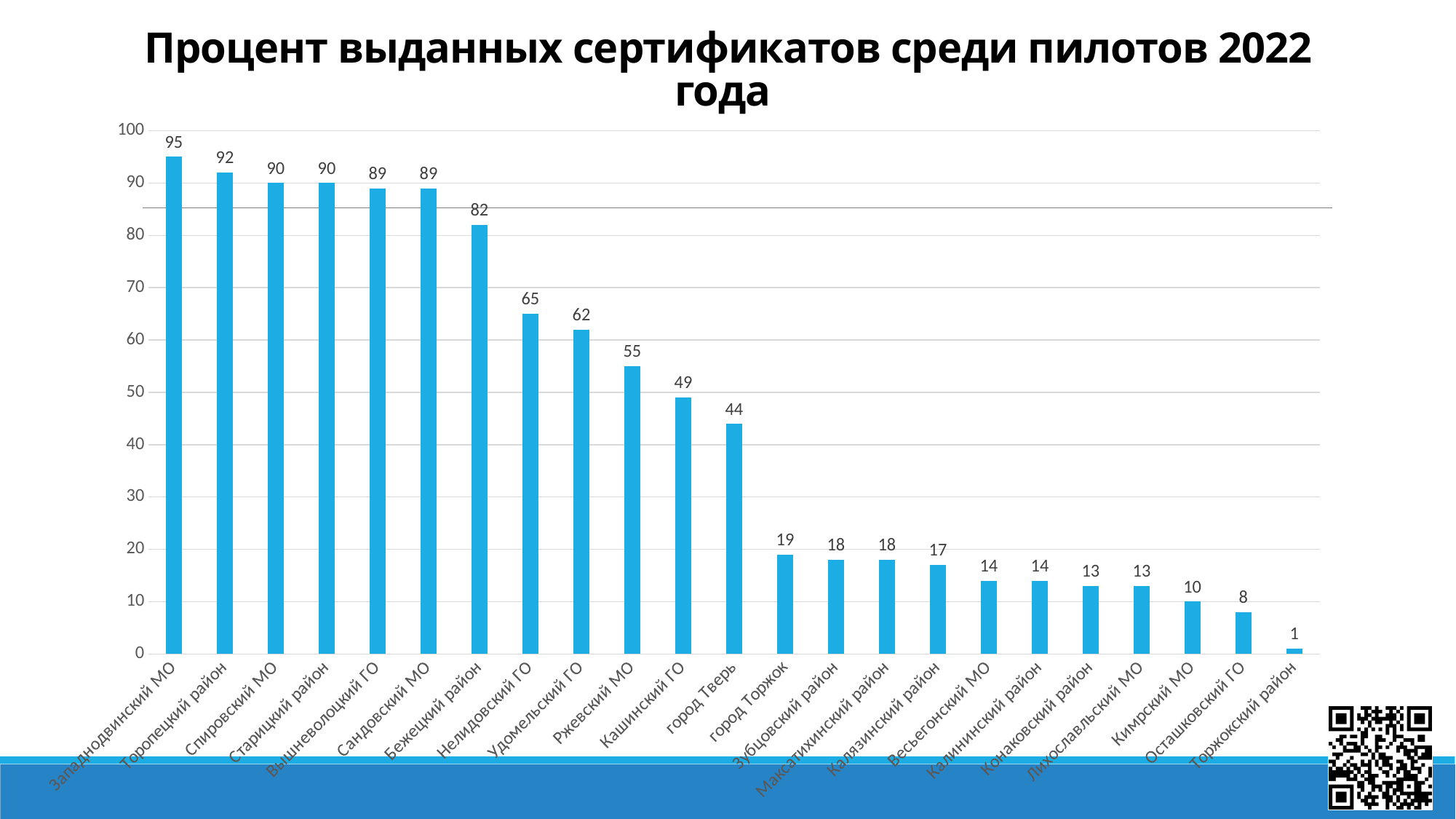
Which category has the lowest value? Торжокский район What is the difference between the values for Нелидовский ГО and Удомельский ГО? 3 What is the difference between the values for Торопецкий район and город Торжок? 73 What is the value for город Тверь? 44 What is the title of the chart? Процент выданных сертификатов среди пилотов 2022 года Which category has the highest value? Западнодвинский МО What is the value for Бежецкий район? 82 What kind of chart is shown on the slide? bar chart Is the value for Осташковский ГО greater or less than 10? less Which is larger, the value for Ржевский МО or the value for Кашинский ГО? Ржевский МО How many categories are shown on the chart? 23 What is the value for Кимрский МО? 10